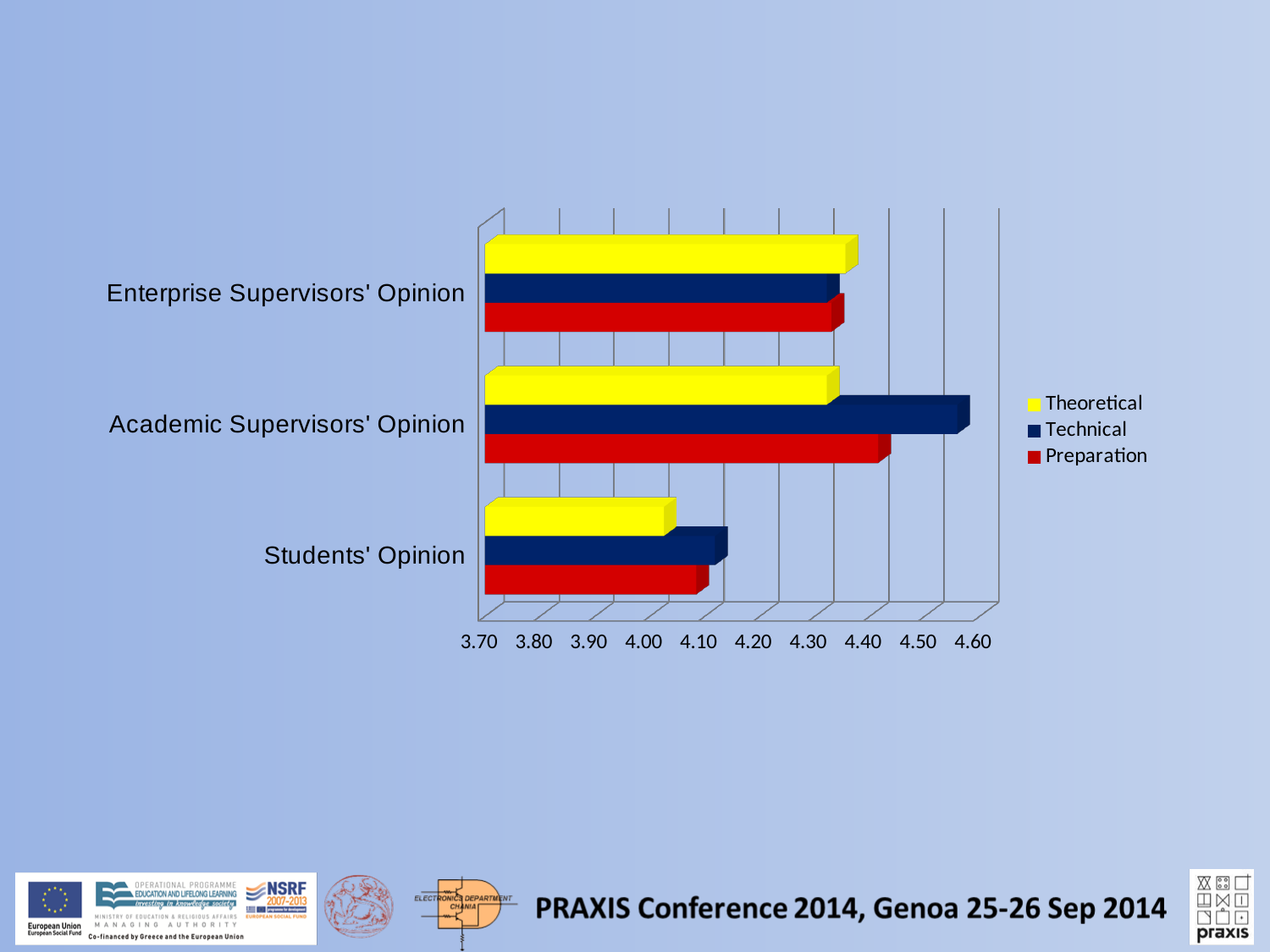
Is the Theoretical value for Students' Opinion greater or less than 4.10? less Which category has the lowest Preparation value? Students' Opinion What kind of chart is shown on the slide? bar chart Is the Technical value for Academic Supervisors' Opinion greater or less than 4.50? greater What colour represents the Technical series in the legend? dark blue Which is larger, the Technical value for Academic Supervisors' Opinion or the Technical value for Students' Opinion? Academic Supervisors' Opinion Which category has the highest Technical value? Academic Supervisors' Opinion How many series does the legend list? 3 Is the Theoretical value for Enterprise Supervisors' Opinion greater or less than 4.30? greater How many categories are shown on the chart? 3 For Academic Supervisors' Opinion, which is larger, the Technical value or the Theoretical value? Technical Which category has the lowest Theoretical value? Students' Opinion